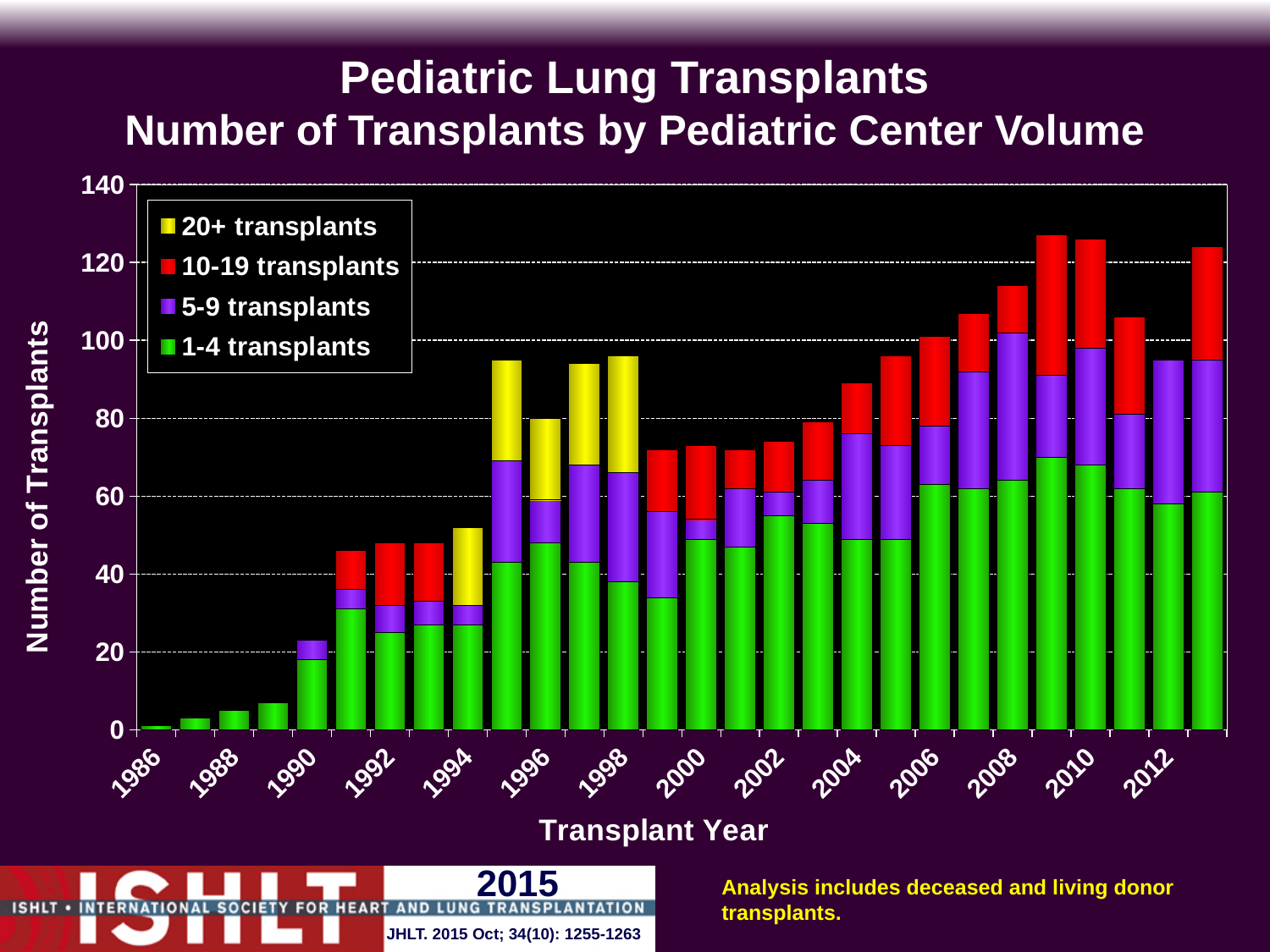
What kind of chart is shown on the slide? stacked bar chart Is the total number of transplants in 2009 greater or less than 120? greater Is the total number of transplants in 1986 greater or less than 20? less Which legend category is shown in yellow? 20+ transplants Is the total number of transplants in 2012 greater or less than 100? less How many series does the legend list? 4 Which year has a higher total number of transplants, 2000 or 2008? 2008 Do the total number of transplants rise or fall from 1986 to 1990? rise What is the label of the x axis? Transplant Year Which transplant year has the lowest total number of transplants? 1986